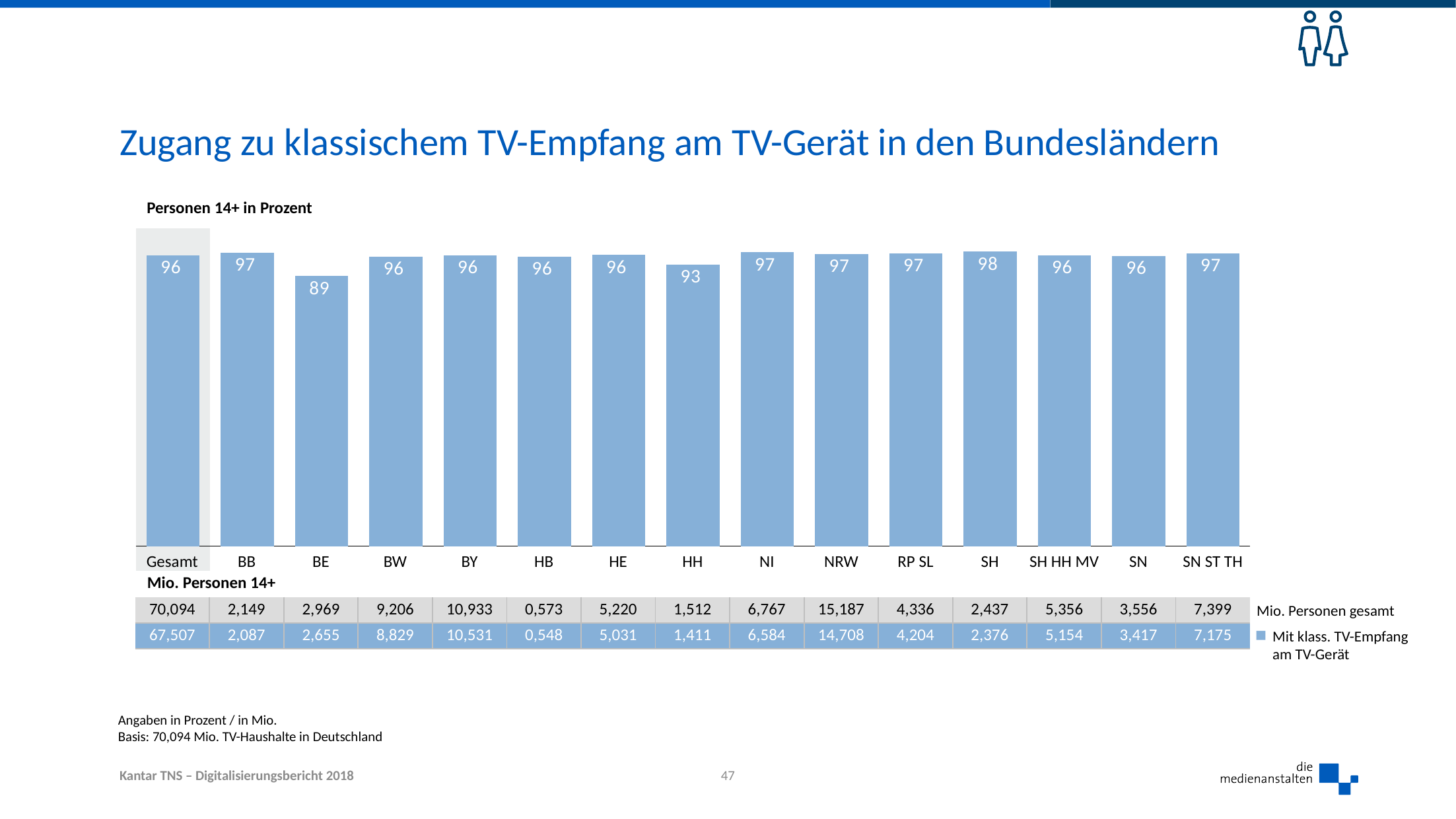
In the table below the chart, what is the value of 'Mio. Personen gesamt' for NRW? 15,187 What percentage is shown for SH in the chart? 98 What type of chart is shown on the slide? Bar chart What percentage is shown for HH in the chart? 93 What percentage is shown for BE in the chart? 89 Which has a higher percentage, HH or NRW? NRW In the table below the chart, what is the value of 'Mit klass. TV-Empfang am TV-Gerät' for BY? 10,531 What is the difference in percentage points between SH and BE? 9 How many bars are shown in the chart, including Gesamt? 15 Which category has the highest percentage in the chart? SH Which category has the lowest percentage in the chart? BE What is the title of the chart on the slide? Zugang zu klassischem TV-Empfang am TV-Gerät in den Bundesländern